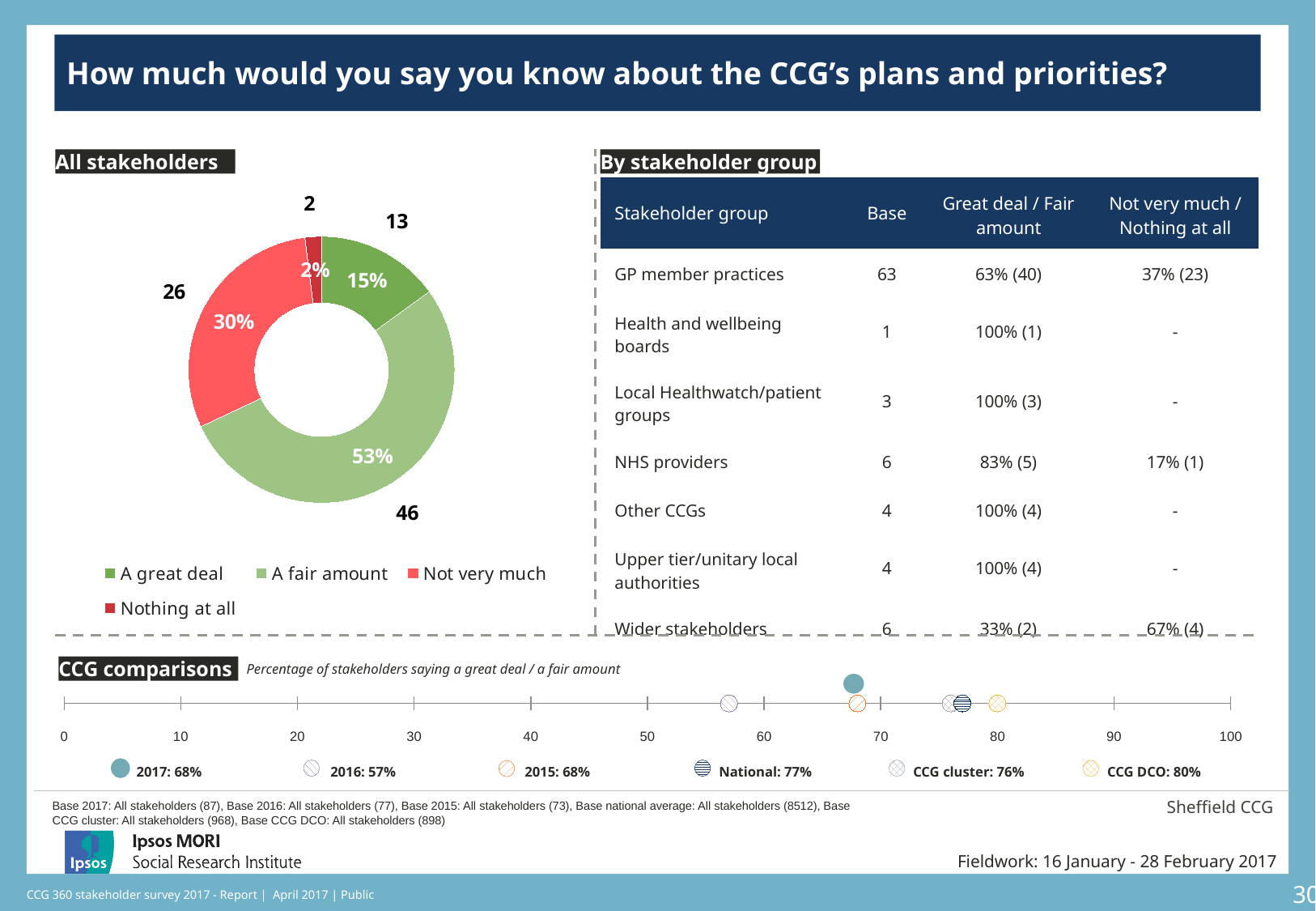
In the 'All stakeholders' chart, which category has the largest share? A fair amount In the 'CCG comparisons' chart, which comparator has the highest value? CCG DCO How many categories does the legend of the 'All stakeholders' chart list? 4 In the 'All stakeholders' chart, what percentage of stakeholders said 'A great deal'? 15% In the 'All stakeholders' chart, which is larger: 'A great deal' or 'Not very much'? Not very much In the 'CCG comparisons' chart, what is the difference between the National value and the 2017 value? 9 percentage points In the 'All stakeholders' chart, what percentage of stakeholders said 'Not very much'? 30% In the 'CCG comparisons' chart, what is the value for 2016? 57% In the 'All stakeholders' chart, which category has the smallest share? Nothing at all In the 'All stakeholders' chart, what is the difference in percentage points between 'A fair amount' and 'Not very much'? 23 What kind of chart is the 'All stakeholders' chart? Donut (pie) chart In the 'All stakeholders' chart, what percentage of stakeholders said 'A fair amount'? 53%